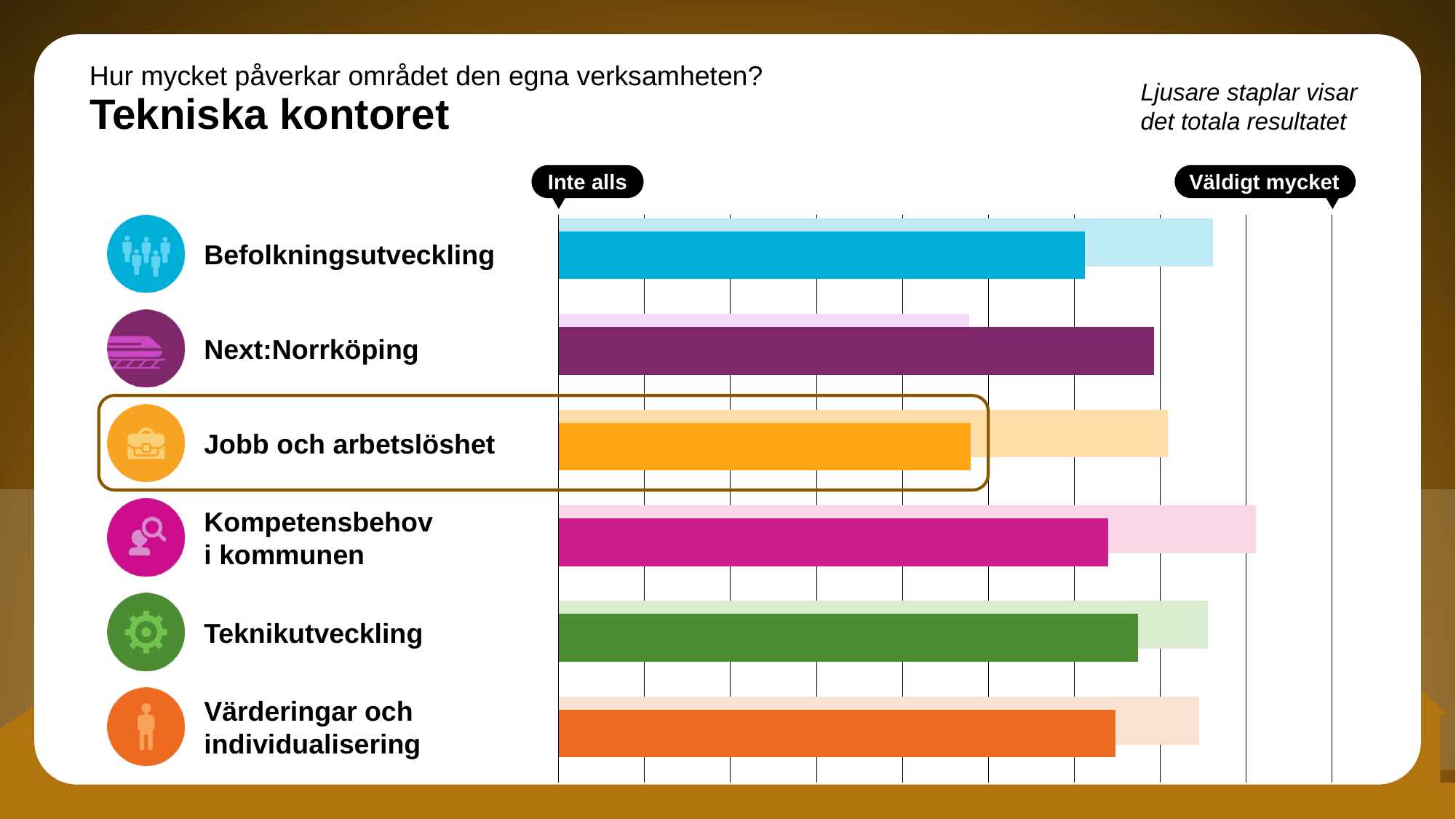
How many categories (areas) are plotted in the chart? 6 What are the two labels at the ends of the chart's horizontal axis? Inte alls and Väldigt mycket According to the note on the slide, what do the lighter bars show? Det totala resultatet Which dark bar is longer: Next:Norrköping or Jobb och arbetslöshet? Next:Norrköping For Next:Norrköping, which bar is longer: the dark bar or the light bar? The dark bar For Jobb och arbetslöshet, which bar is longer: the dark bar or the light bar? The light bar Which category has the shortest light (total result) bar? Next:Norrköping Which category has the shortest dark (Tekniska kontoret) bar? Jobb och arbetslöshet What kind of chart is shown on the slide? Bar chart Which category has the longest light (total result) bar? Kompetensbehov i kommunen